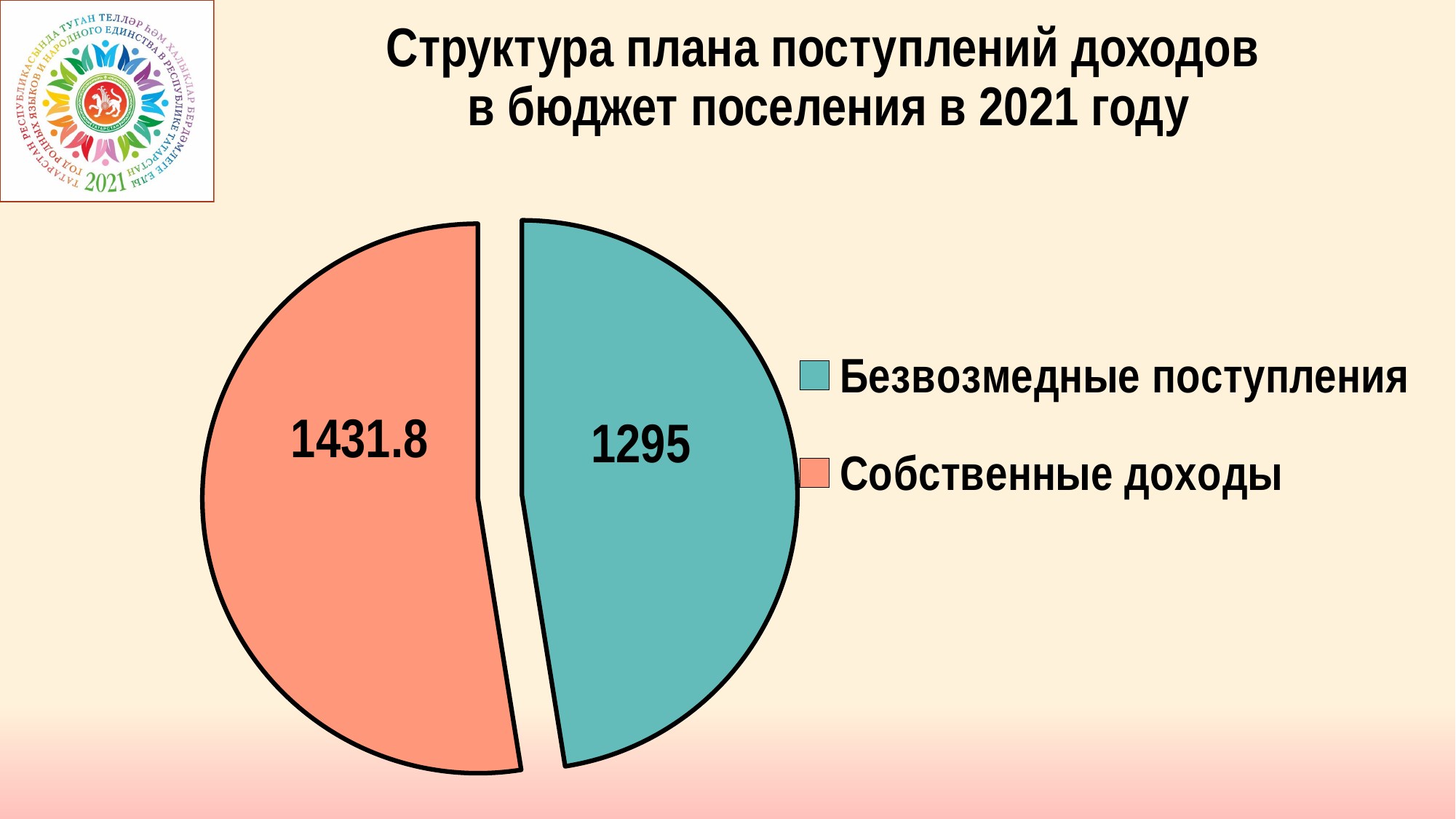
What is the value shown for Собственные доходы? 1431.8 How many entries does the legend list? 2 What is the total of the two slices in the pie chart? 2726.8 What is the difference between the values for Собственные доходы and Безвозмездные поступления? 136.8 Which category has the smaller value? Безвозмездные поступления Which category has the larger value? Собственные доходы What is the value shown for Безвозмездные поступления? 1295 What is the title of the chart on the slide? Структура плана поступлений доходов в бюджет поселения в 2021 году How many slices does the pie chart have? 2 What kind of chart is shown on the slide? pie chart Which colour represents Безвозмездные поступления in the pie chart? teal Is the value for Собственные доходы larger or smaller than the value for Безвозмездные поступления? larger